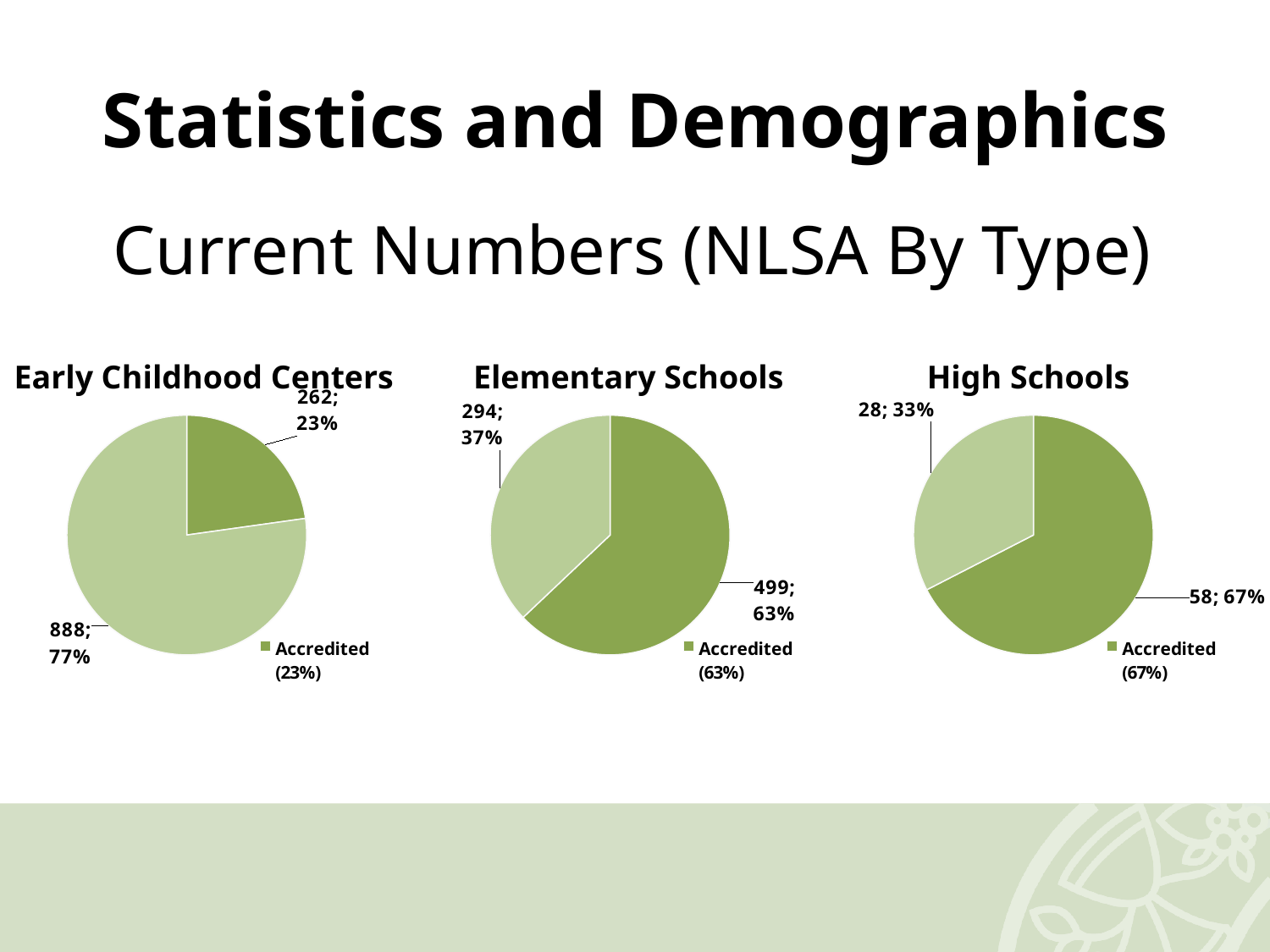
In the High Schools chart, what value is shown for the Accredited slice? 58; 67% In the Elementary Schools chart, what value is shown for the Accredited slice? 499; 63% In the Early Childhood Centers chart, what value is shown for the Accredited slice? 262; 23% How many slices does the Early Childhood Centers pie chart have? 2 In the Elementary Schools chart, what share of the pie does the Accredited slice represent? 63% In the Elementary Schools chart, what is the difference between the two slice counts, 499 and 294? 205 In the Early Childhood Centers chart, what value is shown for the larger, non-accredited slice? 888; 77% What kind of chart is used for the Early Childhood Centers data? pie chart In the High Schools chart, what is the total of the two slices, 58 and 28? 86 In the Early Childhood Centers chart, what share of the pie does the Accredited slice represent? 23% In the High Schools chart, which slice is larger: the Accredited slice or the other slice? Accredited How many entries does the legend of the Elementary Schools chart list? 1